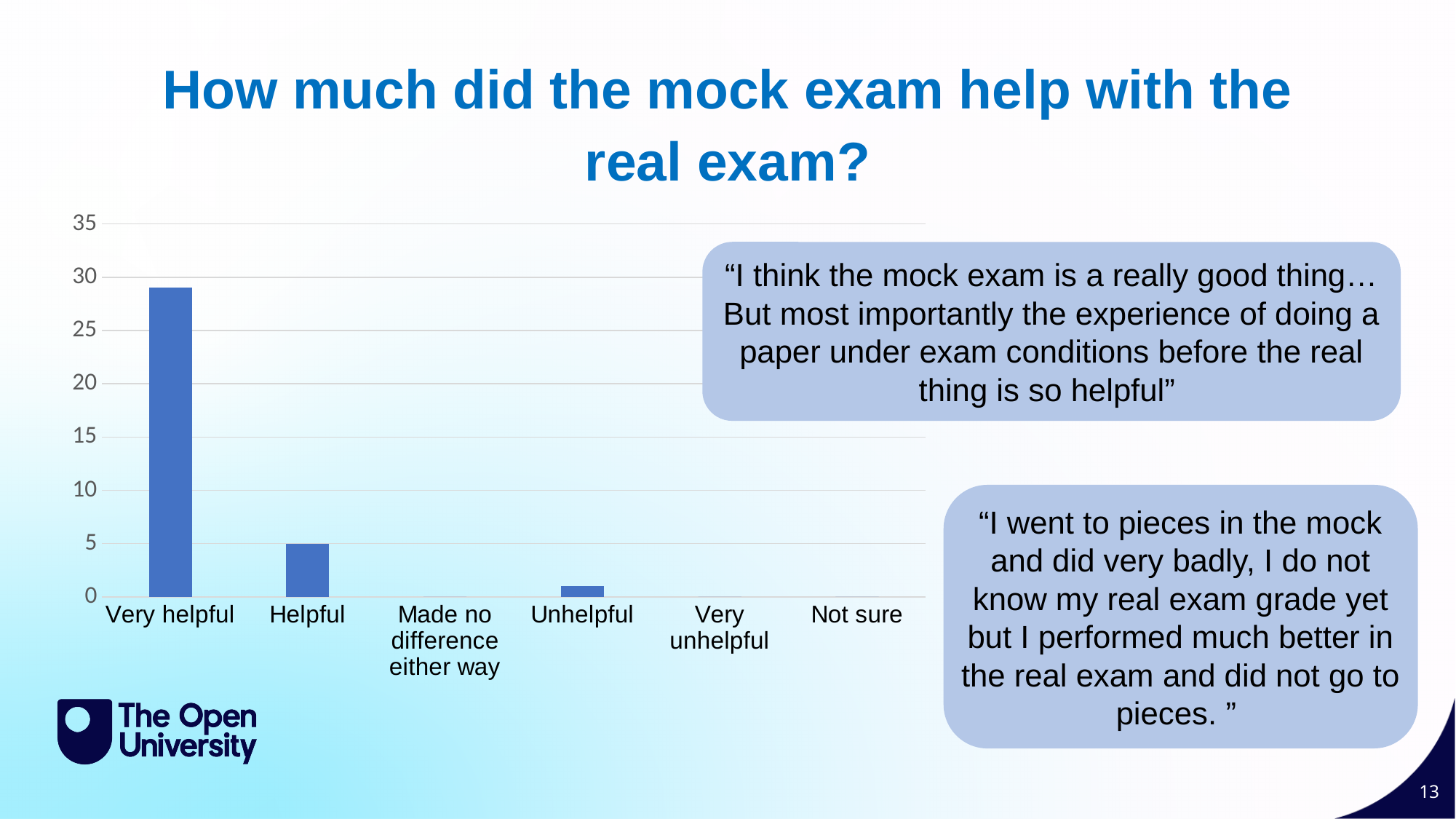
Is the value for Very helpful greater or less than 25? greater What is the highest value shown on the chart's y axis? 35 What is the value for Helpful? 5 Which category has the second-highest bar in the chart? Helpful Which is larger, the value for Very helpful or the value for Helpful? Very helpful Which category has the highest bar in the chart? Very helpful Which is larger, the value for Helpful or the value for Unhelpful? Helpful Is the value for Unhelpful greater or less than 5? less Is the value for Very helpful greater or less than 30? less What kind of chart is shown on the slide? bar chart What is the title of the slide containing the chart? How much did the mock exam help with the real exam? How many categories are shown on the x axis of the chart? 6